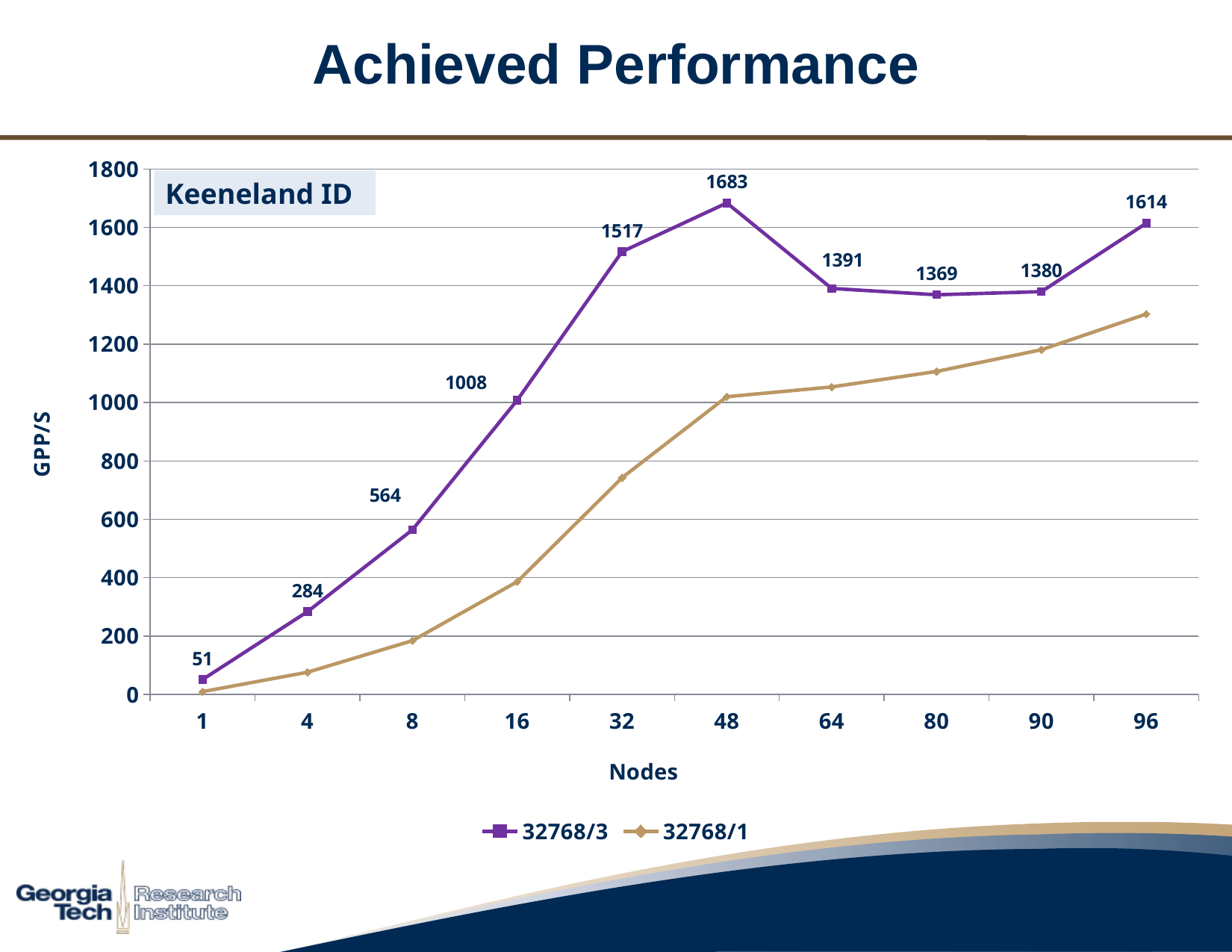
At which node count does the 32768/3 series have its lowest value? 1 What is the difference between the 32768/3 values at 96 nodes and 64 nodes? 223 How many series does the legend list? 2 How many node counts are plotted along the x axis? 10 For the 32768/3 series, which is larger: the value at 32 nodes or the value at 80 nodes? 32 nodes What is the label on the y axis? GPP/S What is the GPP/S value for the 32768/3 series at 16 nodes? 1008 What type of chart is shown on the slide? line chart At which node count does the 32768/3 series reach its highest value? 48 Is the value for the 32768/1 series at 96 nodes greater or less than 1200? greater What is the GPP/S value for the 32768/3 series at 48 nodes? 1683